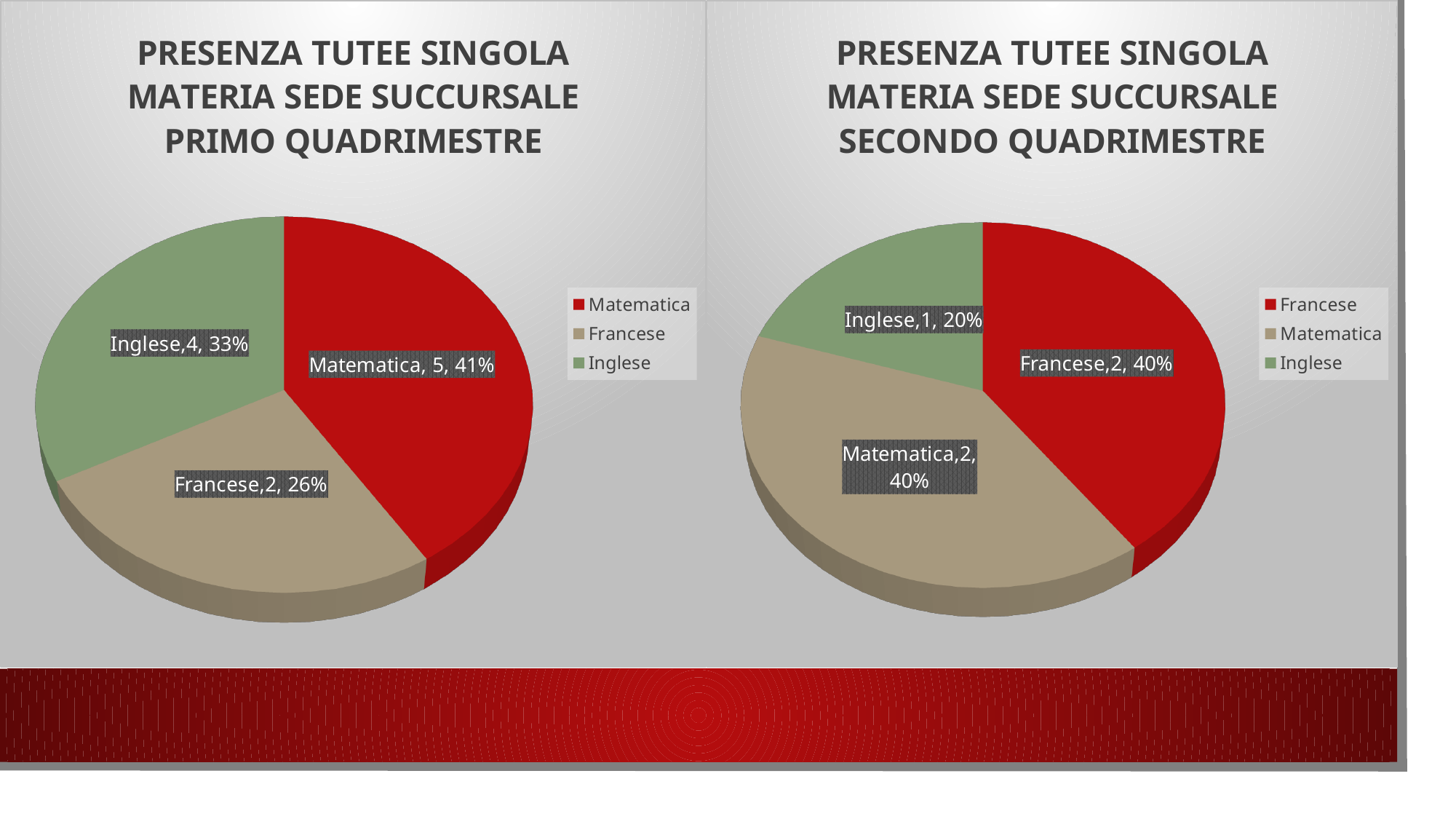
In the 'Secondo Quadrimestre' pie chart on the right, is the value for Francese larger or smaller than the value for Inglese? larger In the 'Secondo Quadrimestre' pie chart on the right, which subject has the smallest slice? Inglese What type of chart is used on the left side of the slide? Pie chart In the 'Secondo Quadrimestre' pie chart on the right, what share of the pie does Francese represent? 40% In the 'Primo Quadrimestre' pie chart on the left, what is the difference between the values for Matematica and Francese? 3 In the 'Primo Quadrimestre' pie chart on the left, what is the value for Matematica? 5 In the 'Primo Quadrimestre' pie chart on the left, which subject has the largest slice? Matematica In the 'Secondo Quadrimestre' pie chart on the right, what is the value for Inglese? 1 In the 'Primo Quadrimestre' pie chart on the left, how many categories are shown? 3 In the 'Secondo Quadrimestre' pie chart on the right, which colour represents Francese in the legend? Red In the 'Primo Quadrimestre' pie chart on the left, what share of the pie does Inglese represent? 33% In the 'Primo Quadrimestre' pie chart on the left, which subject has the smallest slice? Francese